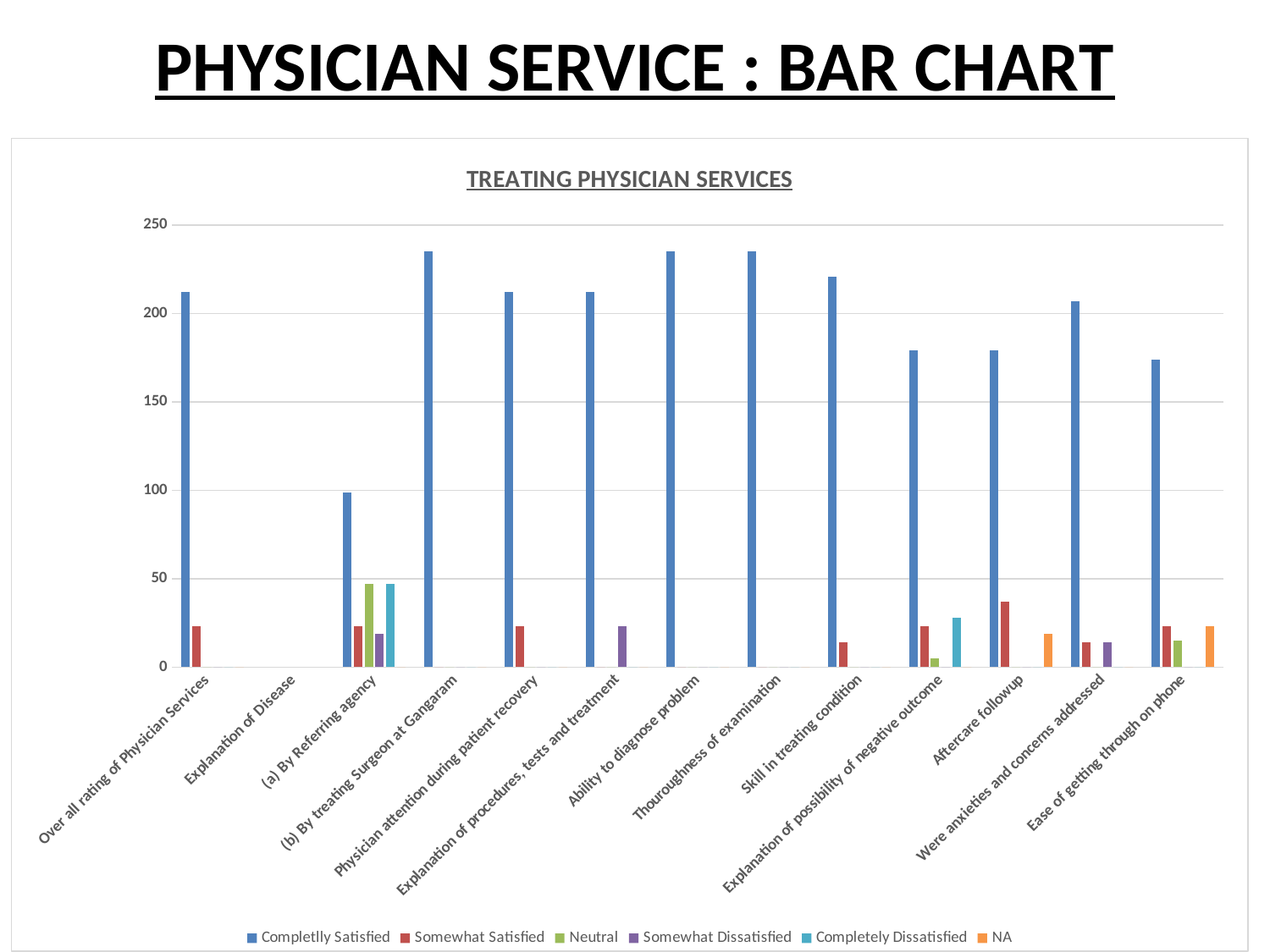
Is the Completlly Satisfied value for Aftercare followup greater or less than 200? less Is the Completlly Satisfied value for Were anxieties and concerns addressed greater or less than 200? greater Which has the larger Completlly Satisfied value: Skill in treating condition or Ease of getting through on phone? Skill in treating condition How many series does the legend list? 6 For (a) By Referring agency, which is larger: the Neutral value or the Somewhat Satisfied value? Neutral Is the Completlly Satisfied value for Ease of getting through on phone greater or less than 150? greater What kind of chart is shown on the slide? bar chart How many categories are shown on the x axis? 13 Which has the larger Somewhat Satisfied value: Aftercare followup or Over all rating of Physician Services? Aftercare followup What is the title of the chart? TREATING PHYSICIAN SERVICES